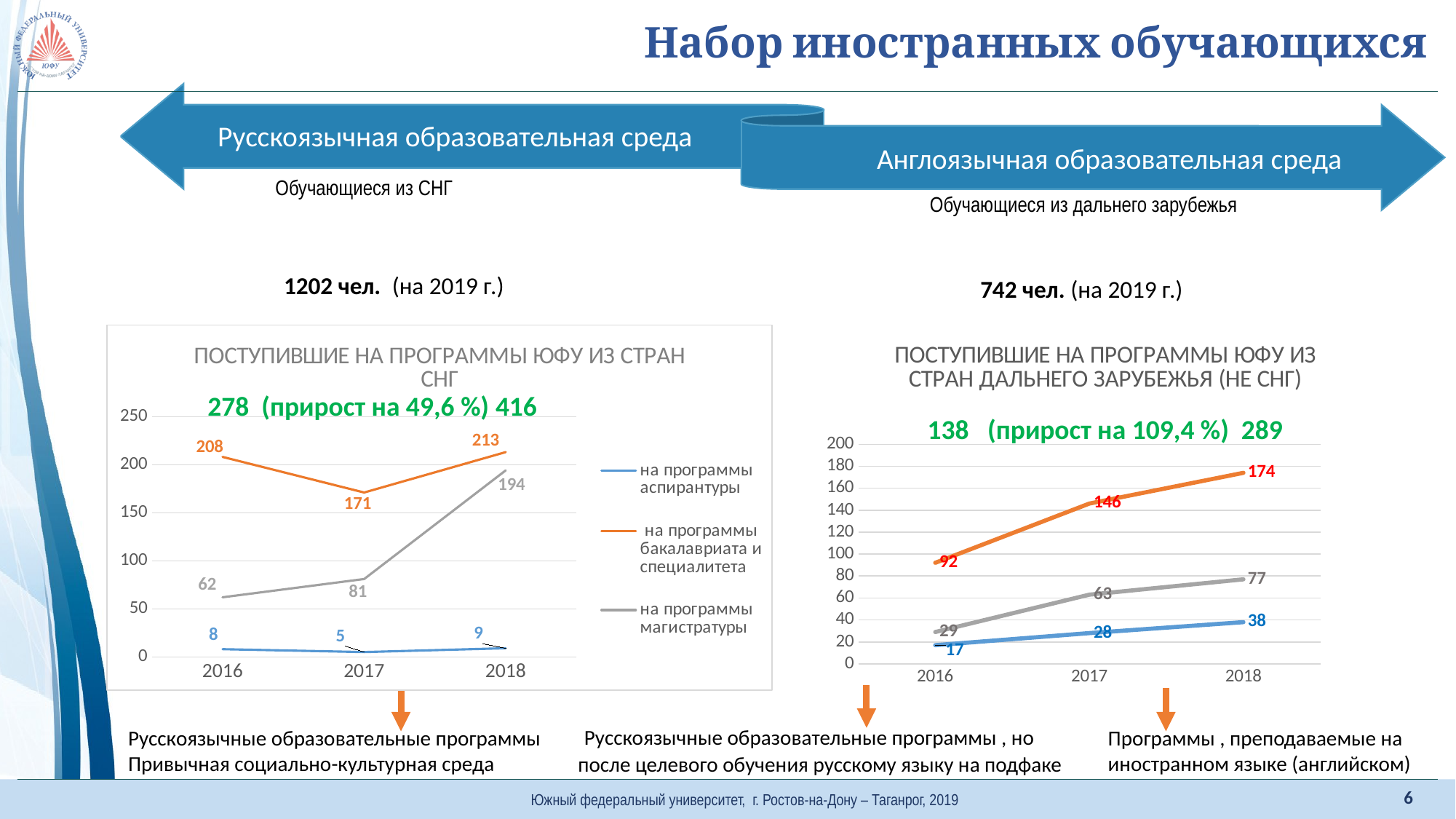
In the chart titled 'ПОСТУПИВШИЕ НА ПРОГРАММЫ ЮФУ ИЗ СТРАН СНГ', what is the value for 'на программы магистратуры' in 2018? 194 In the chart titled 'ПОСТУПИВШИЕ НА ПРОГРАММЫ ЮФУ ИЗ СТРАН СНГ', what is the difference between the 2018 and 2016 values for 'на программы магистратуры'? 132 In the chart titled 'ПОСТУПИВШИЕ НА ПРОГРАММЫ ЮФУ ИЗ СТРАН СНГ', how many series does the legend list? 3 In the chart titled 'ПОСТУПИВШИЕ НА ПРОГРАММЫ ЮФУ ИЗ СТРАН ДАЛЬНЕГО ЗАРУБЕЖЬЯ (НЕ СНГ)', what is the value of the blue line in 2016? 17 In the chart titled 'ПОСТУПИВШИЕ НА ПРОГРАММЫ ЮФУ ИЗ СТРАН ДАЛЬНЕГО ЗАРУБЕЖЬЯ (НЕ СНГ)', what is the value of the orange line in 2018? 174 In the chart titled 'ПОСТУПИВШИЕ НА ПРОГРАММЫ ЮФУ ИЗ СТРАН СНГ', in which year is the value for 'на программы аспирантуры' lowest? 2017 In the chart titled 'ПОСТУПИВШИЕ НА ПРОГРАММЫ ЮФУ ИЗ СТРАН ДАЛЬНЕГО ЗАРУБЕЖЬЯ (НЕ СНГ)', which is larger in 2017: the grey line or the blue line? the grey line In the chart titled 'ПОСТУПИВШИЕ НА ПРОГРАММЫ ЮФУ ИЗ СТРАН СНГ', what is the value for 'на программы бакалавриата и специалитета' in 2017? 171 What kind of chart is the one titled 'ПОСТУПИВШИЕ НА ПРОГРАММЫ ЮФУ ИЗ СТРАН ДАЛЬНЕГО ЗАРУБЕЖЬЯ (НЕ СНГ)'? line chart How many years are shown on the x axis of the chart titled 'ПОСТУПИВШИЕ НА ПРОГРАММЫ ЮФУ ИЗ СТРАН ДАЛЬНЕГО ЗАРУБЕЖЬЯ (НЕ СНГ)'? 3 In the chart titled 'ПОСТУПИВШИЕ НА ПРОГРАММЫ ЮФУ ИЗ СТРАН ДАЛЬНЕГО ЗАРУБЕЖЬЯ (НЕ СНГ)', what is the difference between the orange line's 2017 and 2016 values? 54 In the chart titled 'ПОСТУПИВШИЕ НА ПРОГРАММЫ ЮФУ ИЗ СТРАН СНГ', does the value for 'на программы магистратуры' rise or fall from 2016 to 2018? rise